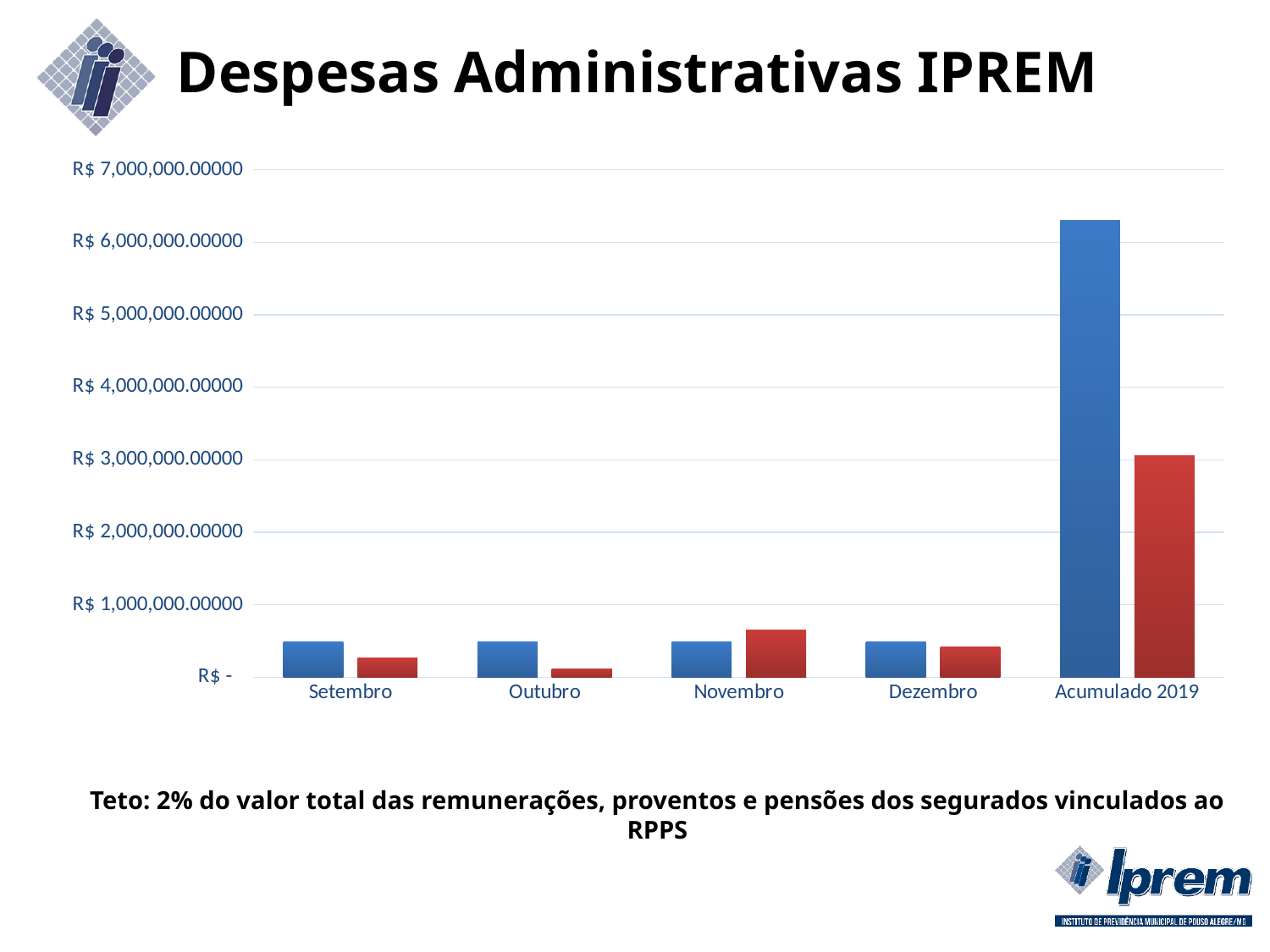
What kind of chart is shown on the slide? bar chart What is the title of the slide containing the chart? Despesas Administrativas IPREM Is the blue bar for Acumulado 2019 greater or less than R$ 6,000,000.00000? greater How many categories are shown on the x axis of the chart? 5 For Outubro, which bar is taller, the blue one or the red one? the blue one Which category has the tallest blue bar? Acumulado 2019 How many data series (bar colours) are plotted in the chart? 2 For Novembro, which bar is taller, the blue one or the red one? the red one Which category has the shortest red bar? Outubro For Acumulado 2019, which bar is taller, the blue one or the red one? the blue one Is the red bar for Acumulado 2019 greater or less than R$ 2,000,000.00000? greater Is the red bar for Novembro greater or less than R$ 1,000,000.00000? less